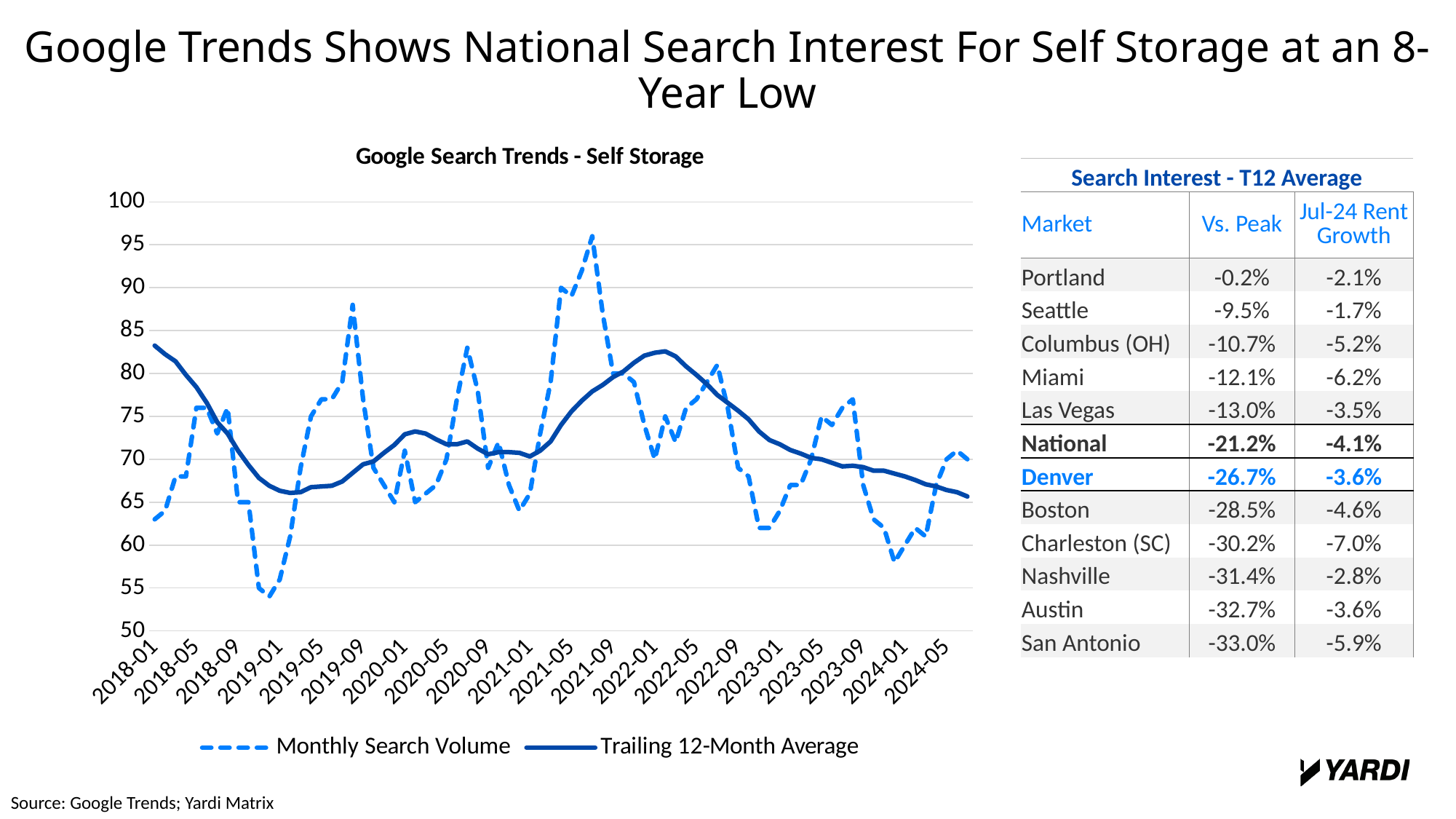
Is the Trailing 12-Month Average value at 2024-05 greater or less than 70? less What kind of chart is shown on the slide? line chart Is the peak value of Monthly Search Volume around 2021-07 greater or less than 90? greater Which series is drawn with a dashed line? Monthly Search Volume Does the Trailing 12-Month Average rise or fall between 2019-01 and 2022-01? rise Is the Monthly Search Volume value at 2019-09 greater or less than 85? less How many series does the chart legend list? 2 Does the Trailing 12-Month Average rise or fall between 2022-01 and 2024-05? fall What is the title of the chart? Google Search Trends - Self Storage